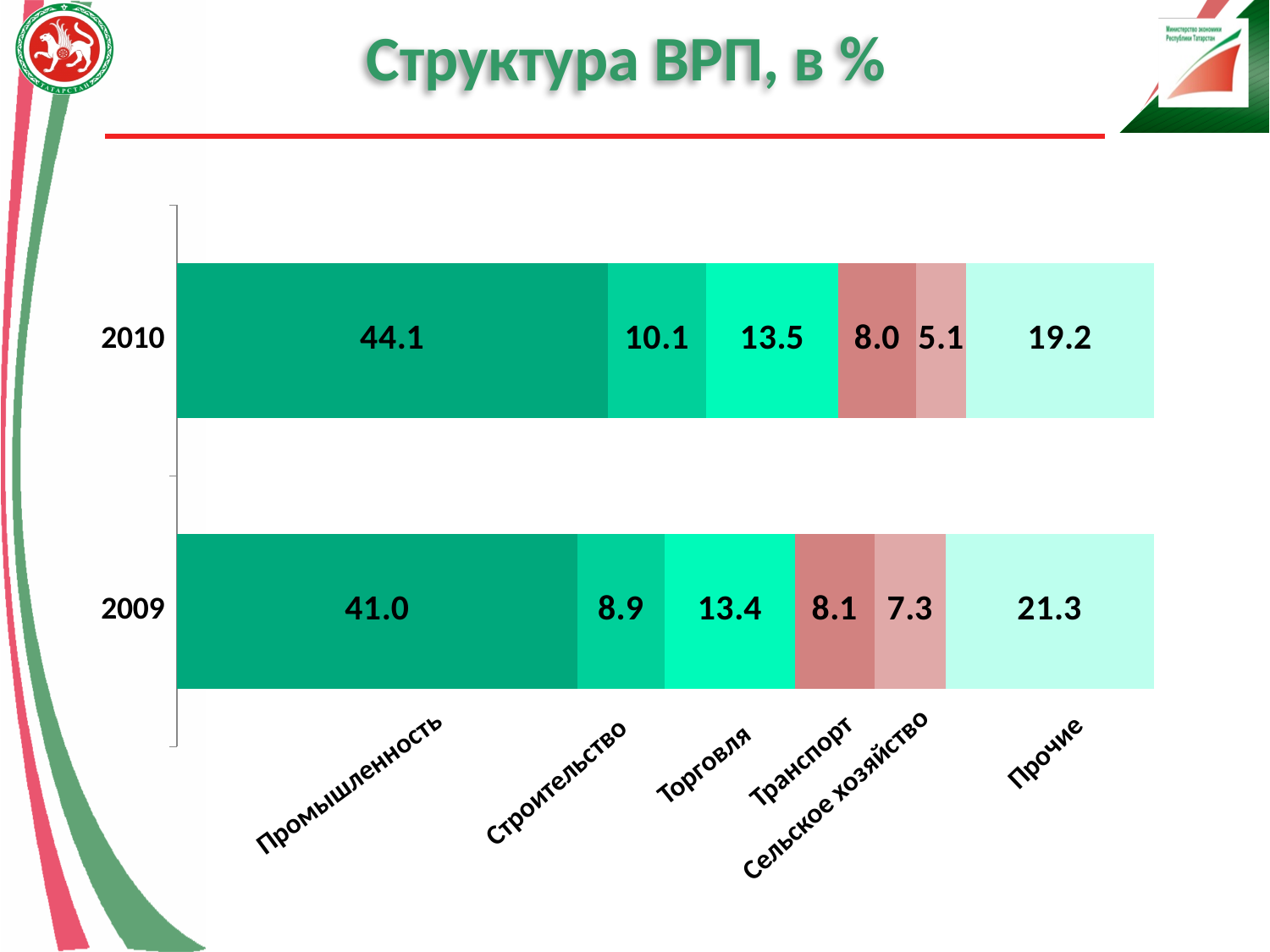
What kind of chart is shown on the slide? Stacked bar chart Which segment is the smallest in the 2010 bar? Сельское хозяйство What is the value for Прочие in 2009? 21.3 What is the value for Промышленность in 2010? 44.1 Which segment is the largest in the 2009 bar? Промышленность How many segments (sectors) make up each bar? 6 What is the title of the chart? Структура ВРП, в % How many bars (years) are shown in the chart? 2 What is the value for Сельское хозяйство in 2010? 5.1 Which is larger: Прочие in 2009 or Прочие in 2010? Прочие in 2009 What is the value for Строительство in 2009? 8.9 What is the difference between the Промышленность values for 2010 and 2009? 3.1